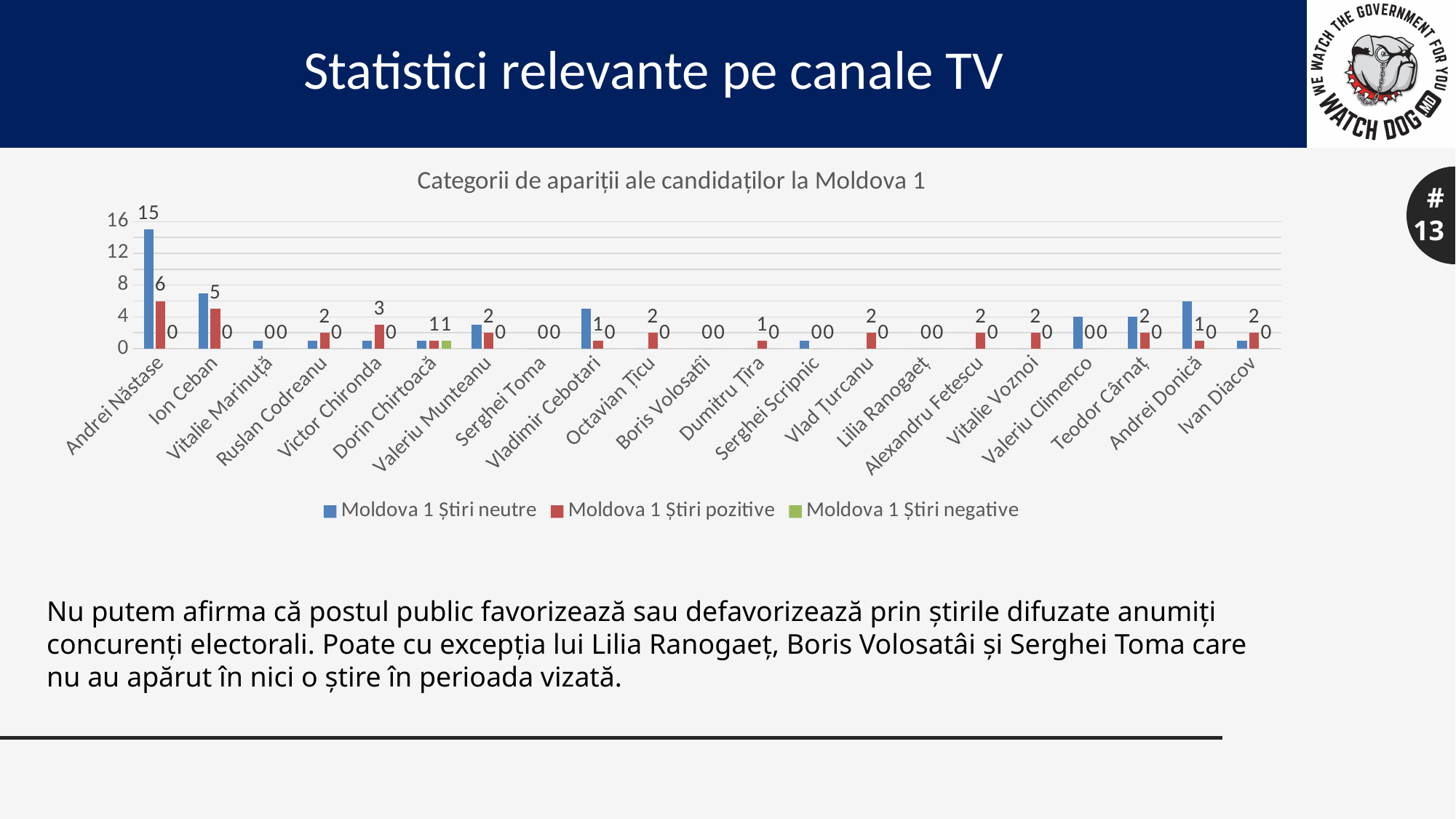
How many candidates are shown on the x axis of the chart? 21 Which is larger: Moldova 1 Știri pozitive for Victor Chironda or for Ruslan Codreanu? Victor Chironda What is the value of Moldova 1 Știri negative for Dorin Chirtoacă? 1 What is the value of Moldova 1 Știri pozitive for Ion Ceban? 5 What is the title of the chart? Categorii de apariții ale candidaților la Moldova 1 Which candidate has the highest value for Moldova 1 Știri pozitive? Andrei Năstase What is the difference between Moldova 1 Știri neutre and Moldova 1 Știri pozitive for Andrei Năstase? 9 How many series does the legend list? 3 Is the value of Moldova 1 Știri neutre for Ion Ceban greater or less than 4? greater What is the value of Moldova 1 Știri neutre for Andrei Năstase? 15 What type of chart is shown on the slide? bar chart What is the value of Moldova 1 Știri pozitive for Victor Chironda? 3